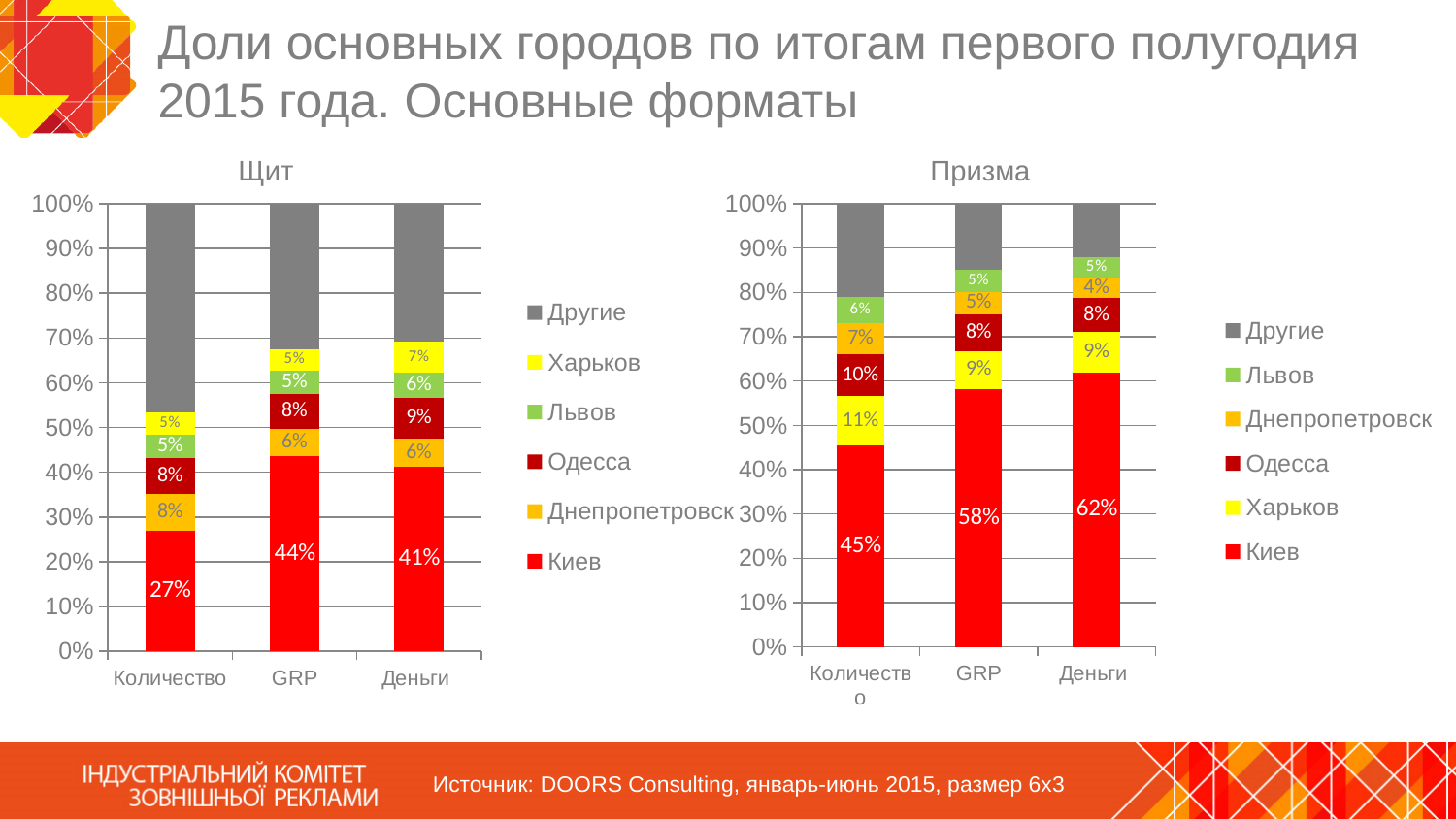
In the Призма chart, which is larger: the Киев value for GRP or for Деньги? Деньги In the Щит chart, which category has the highest value for Киев? GRP In the Щит chart, what is the value for Киев in the Количество bar? 27% What kind of chart is the Призма chart? Stacked bar chart In the Щит chart, is the Другие share of the Количество bar greater or less than 40%? greater In the Призма chart, what is the value for Харьков in the Количество bar? 11% In the Призма chart, what is the value for Киев in the Деньги bar? 62% How many categories are shown on the x axis of the Призма chart? 3 How many series does the legend of the Щит chart list? 6 In the Призма chart, which category has the lowest value for Киев? Количество In the Щит chart, what is the difference between the Киев values for GRP and Количество? 17 percentage points In the Щит chart, what is the value for Одесса in the Деньги bar? 9%